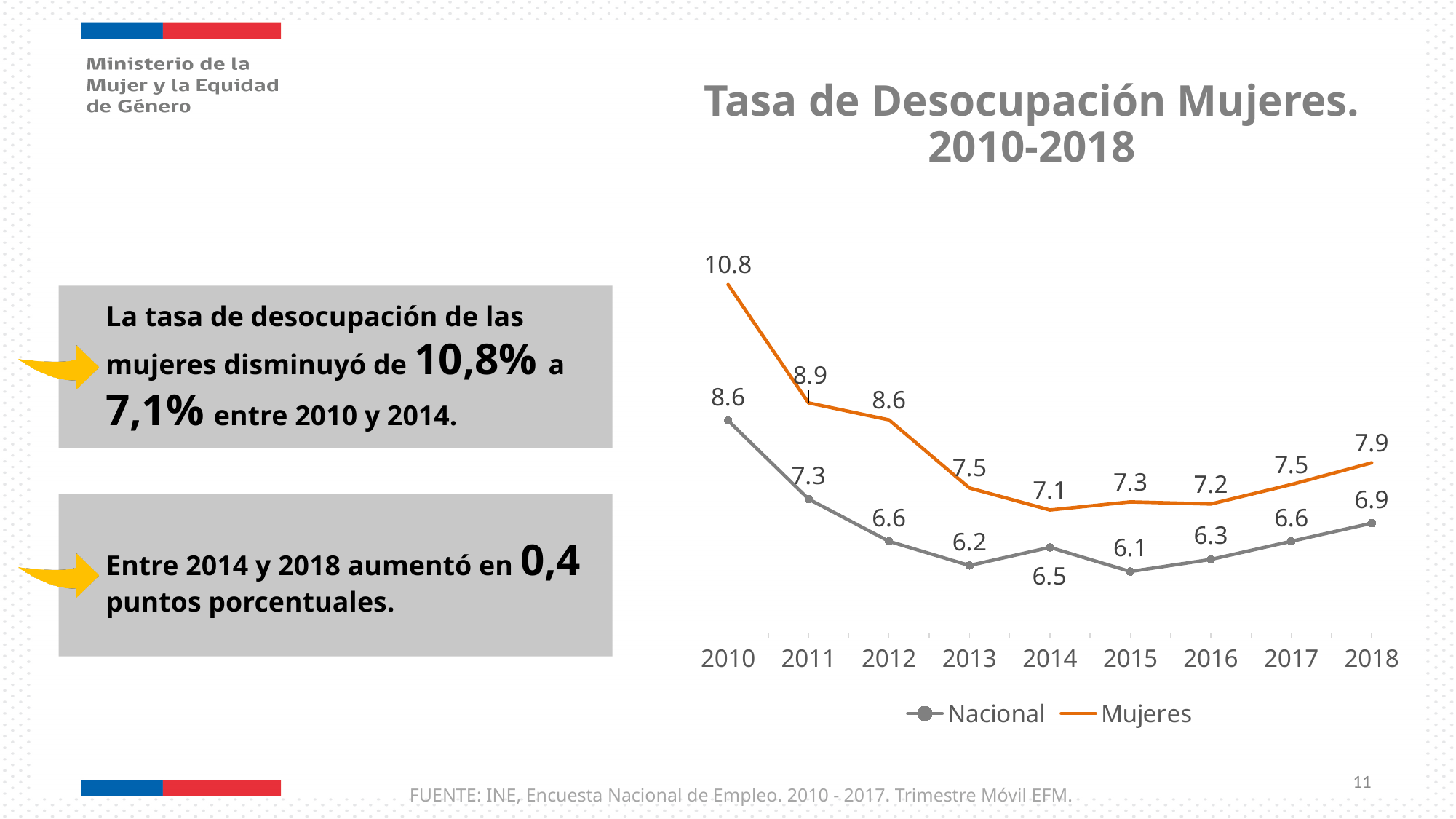
What is the value for Nacional in 2015? 6.1 What is the difference between the Mujeres and Nacional values in 2010? 2.2 In which year is the Mujeres series at its lowest? 2014 How many years are plotted on the x axis? 9 How many series does the legend list? 2 What is the value for Mujeres in 2018? 7.9 In which year is the Nacional series at its highest? 2010 What colour is the Mujeres line? Orange What is the value for Mujeres in 2010? 10.8 Which series has the larger value in 2013, Nacional or Mujeres? Mujeres What type of chart is shown on the slide? Line chart Does the Mujeres series rise or fall between 2010 and 2014? Fall